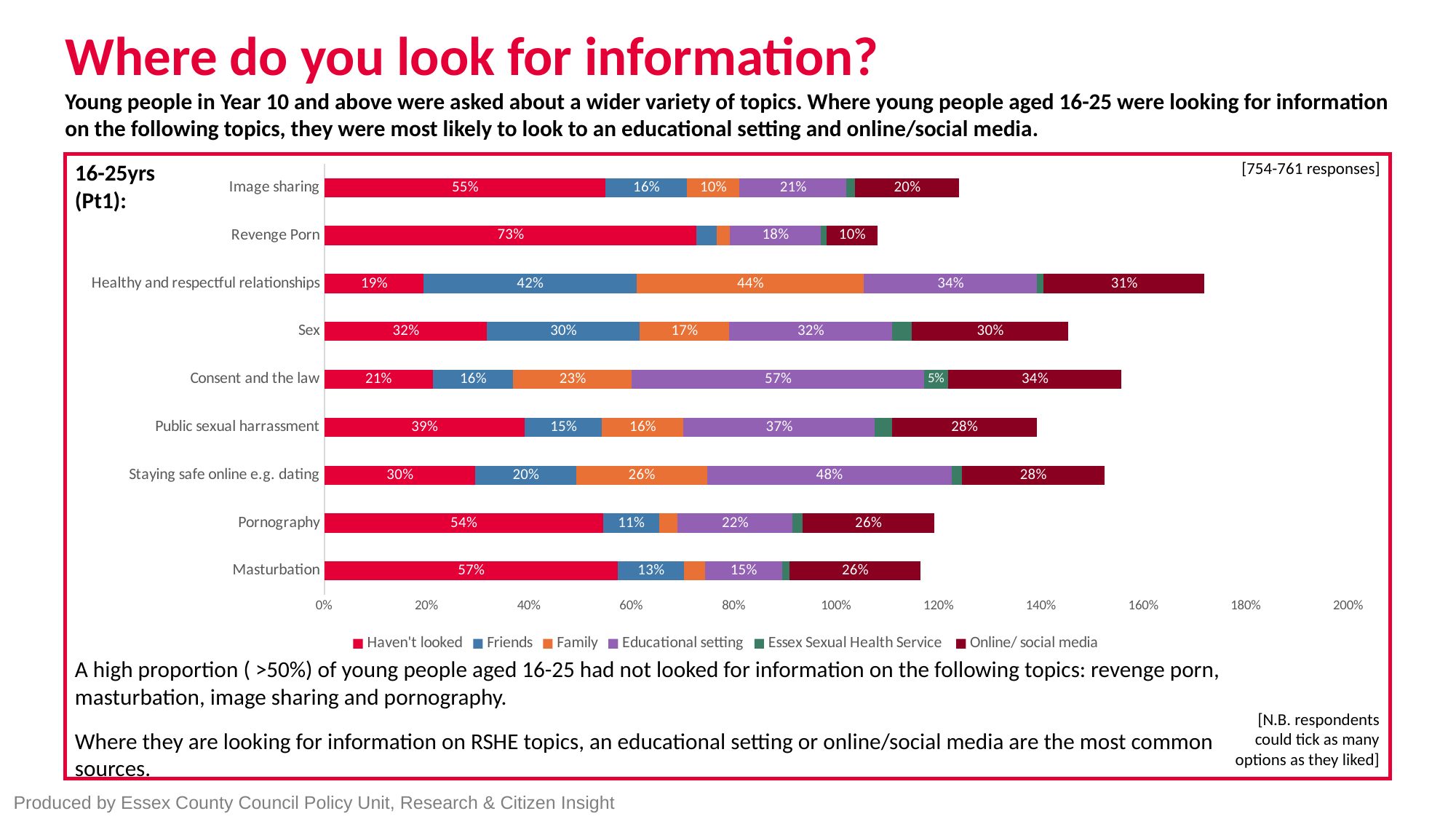
What kind of chart is shown on the slide? Stacked bar chart What is the Family value for Healthy and respectful relationships? 44% Which topic has the highest Educational setting value? Consent and the law Which has the larger Friends value: Healthy and respectful relationships or Sex? Healthy and respectful relationships What is the Online/ social media value for Sex? 30% Is the total length of the Healthy and respectful relationships bar greater or less than 160%? greater What is the Educational setting value for Consent and the law? 57% How many topics (categories) are plotted on the chart? 9 What is the difference between the 'Haven't looked' values for Revenge Porn and Image sharing? 18 percentage points How many series does the chart legend list? 6 What percentage of 16-25 year olds had not looked for information on Revenge Porn? 73% Which topic has the highest 'Haven't looked' value? Revenge Porn